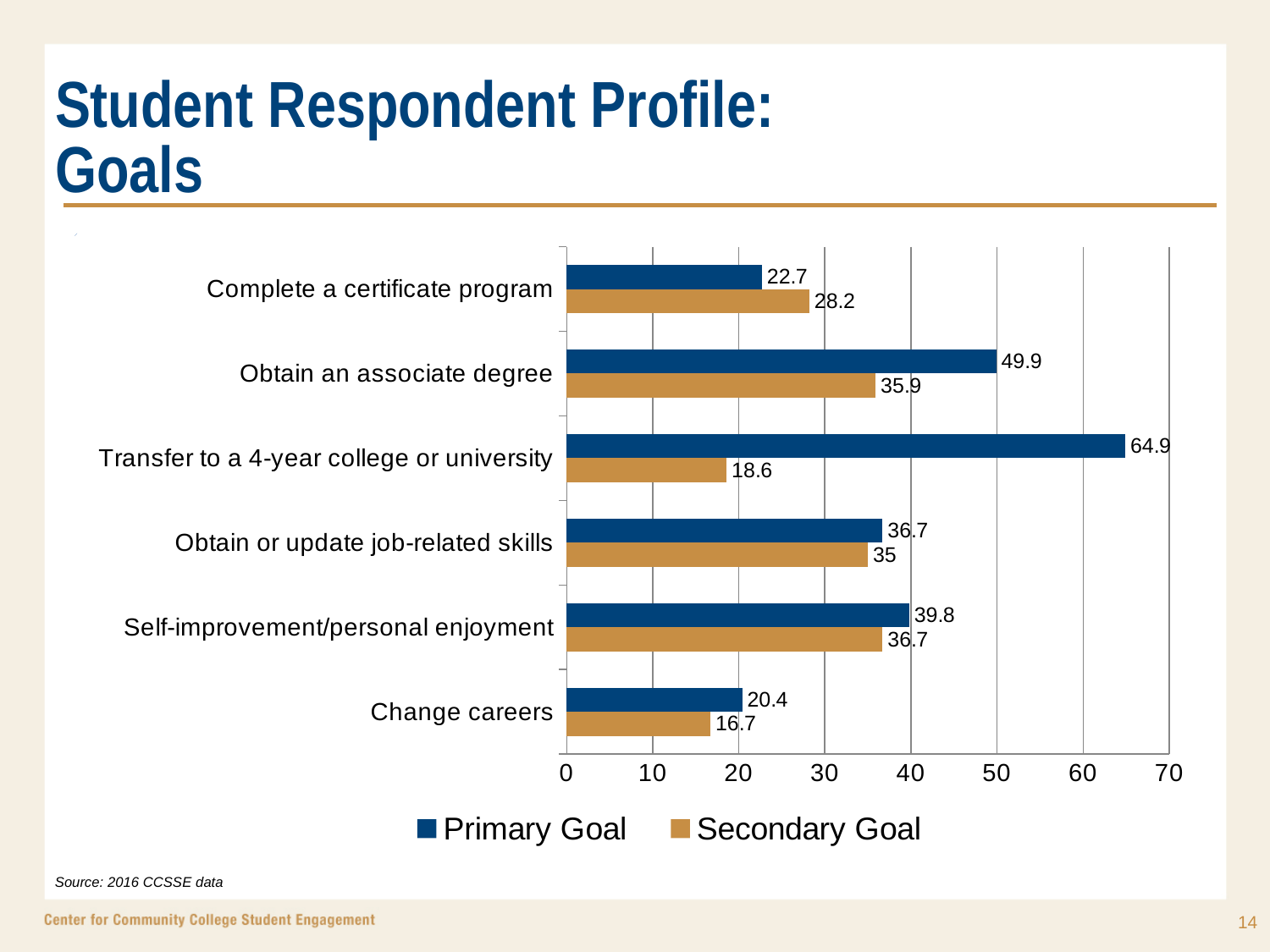
Which is larger for Complete a certificate program: the Primary Goal value or the Secondary Goal value? Secondary Goal What is the difference between the Primary Goal and Secondary Goal values for Transfer to a 4-year college or university? 46.3 Which category has the lowest Secondary Goal value? Change careers Which category has the highest Primary Goal value? Transfer to a 4-year college or university How many series does the legend list? 2 What is the difference between the Primary Goal and Secondary Goal values for Obtain an associate degree? 14 What is the Secondary Goal value for Change careers? 16.7 What is the Secondary Goal value for Complete a certificate program? 28.2 Which colour represents the Secondary Goal series? Gold/tan What kind of chart is shown on the slide? Bar chart What is the Primary Goal value for Transfer to a 4-year college or university? 64.9 How many goal categories are shown on the chart? 6